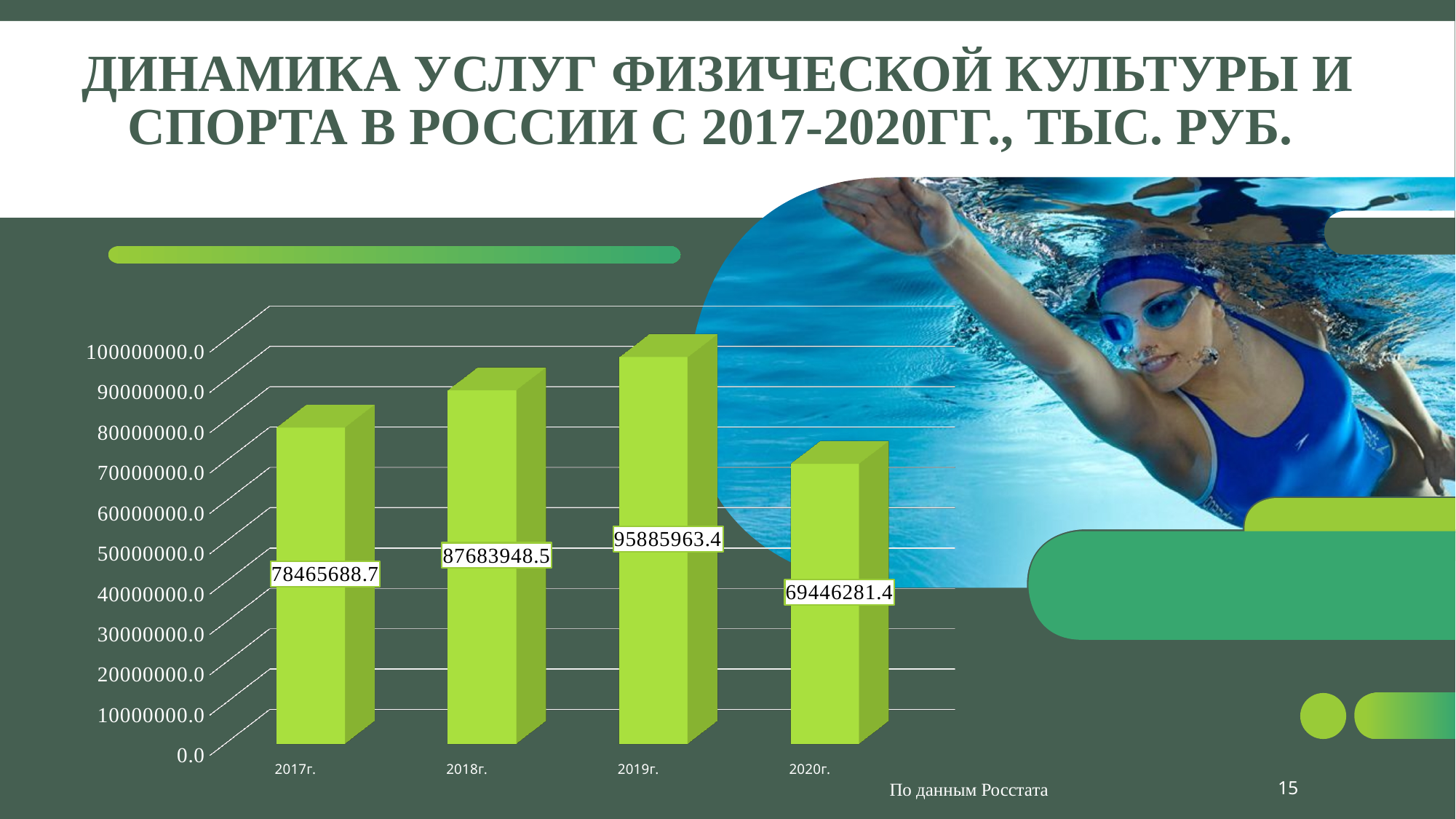
Do the values rise or fall from 2019г. to 2020г.? fall What is the value for 2020г.? 69446281.4 Is the value for 2020г. greater or less than 80000000.0? less Which year has the highest value? 2019г. Which year has the lowest value? 2020г. What is the difference between the values for 2019г. and 2018г.? 8202014.9 What kind of chart is shown on the slide? bar chart What is the difference between the values for 2017г. and 2020г.? 9019407.3 What is the value for 2017г.? 78465688.7 How many years are shown on the x axis? 4 Which is larger, the value for 2018г. or the value for 2020г.? 2018г. What is the value for 2019г.? 95885963.4